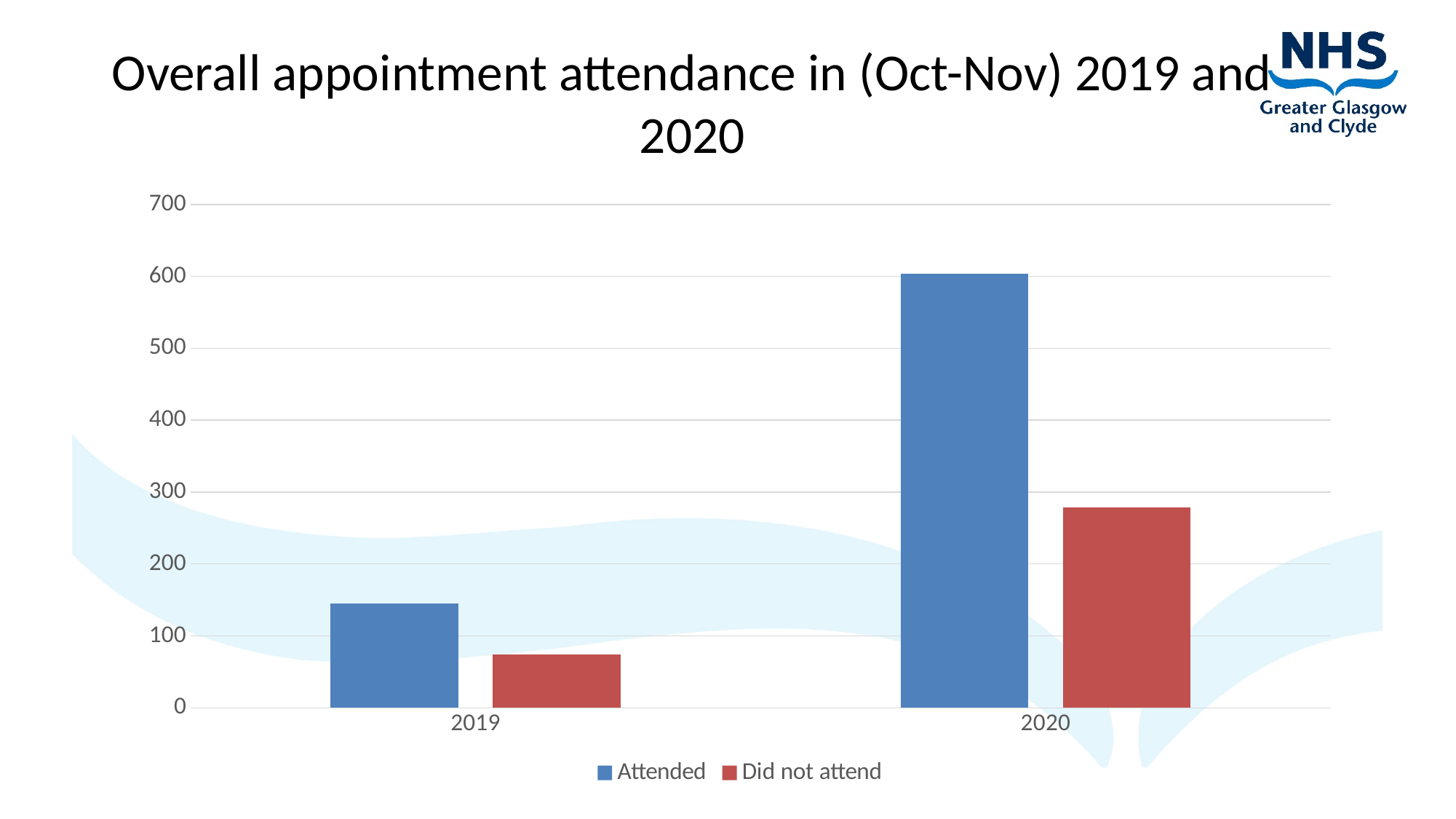
Is the Did not attend value for 2019 greater or less than 100? less Which year has the lowest Did not attend value? 2019 Does the Attended value rise or fall from 2019 to 2020? rise Is the Attended value for 2019 greater or less than 200? less Which year has the highest Attended value? 2020 Is the Did not attend value for 2020 greater or less than 200? greater Which is larger in 2020, Attended or Did not attend? Attended What colour are the Did not attend bars? red How many series does the legend list? 2 What kind of chart is shown on the slide? bar chart How many year categories are shown on the x axis? 2